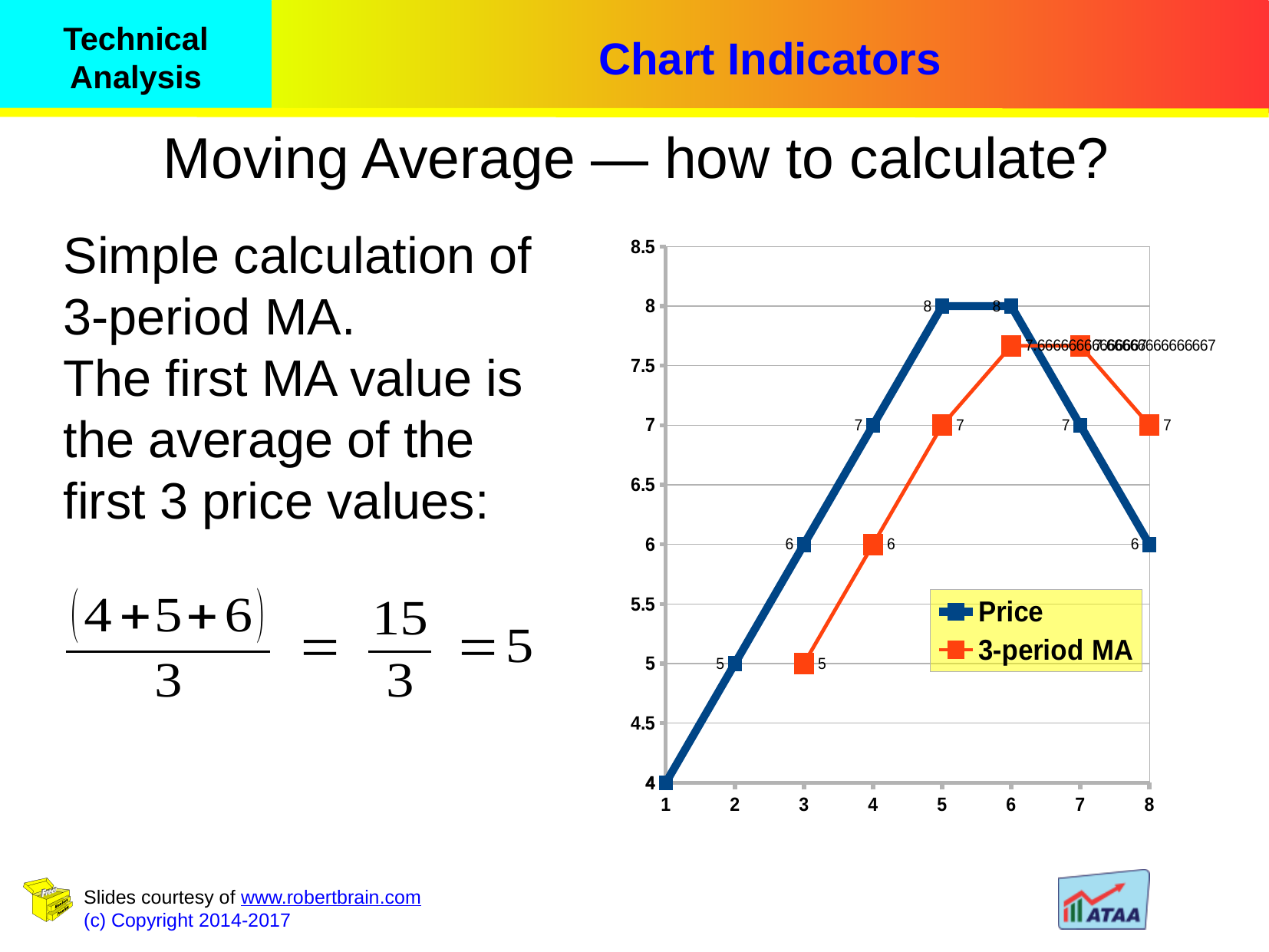
What is the highest Price value plotted on the chart? 8 What is the difference between the Price value at period 5 and the Price value at period 2? 3 What is the 3-period MA value at period 3? 5 What are the two series named in the chart legend? Price and 3-period MA How many series does the chart legend list? 2 What is the Price value at period 5? 8 What is the Price value at period 8? 6 What is the lowest Price value plotted on the chart? 4 What is the 3-period MA value at period 8? 7 At period 8, which is larger: the Price value or the 3-period MA value? 3-period MA What kind of chart is shown on the slide? line chart Is the 3-period MA value at period 6 greater or less than 7.5? greater